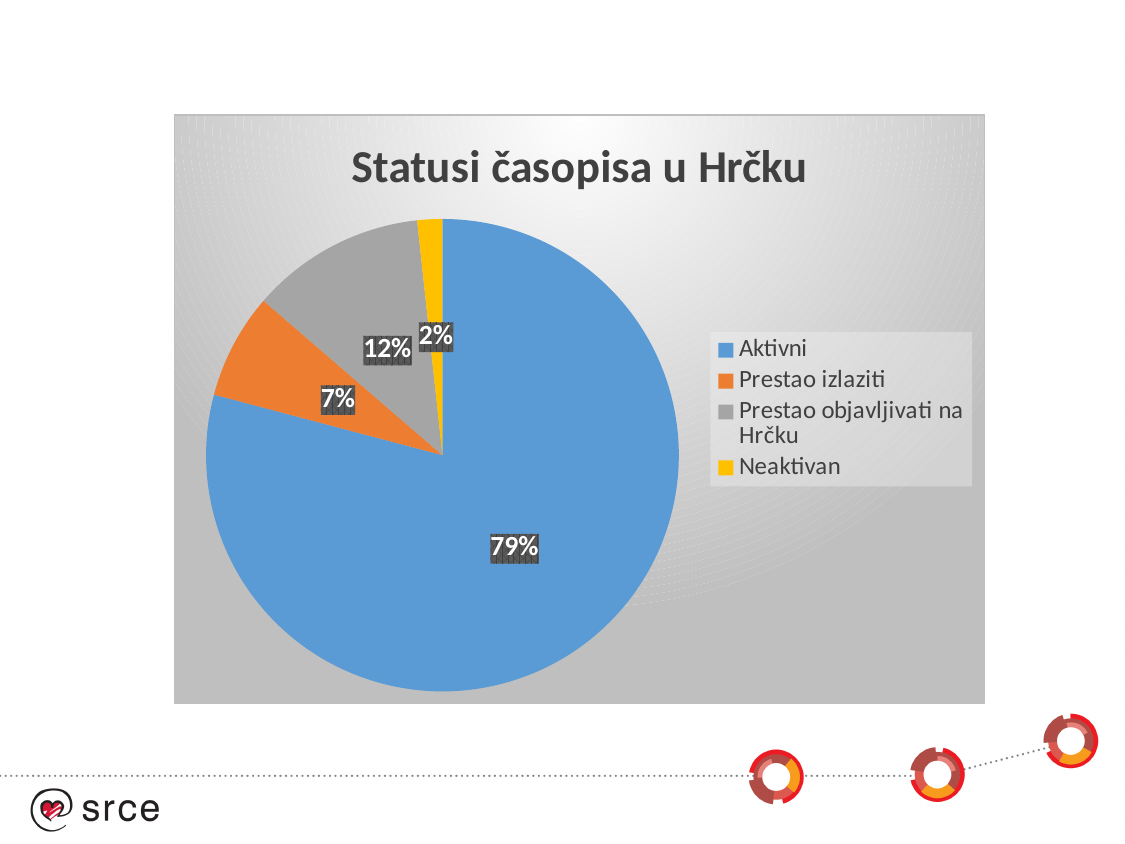
What share of the pie does Prestao objavljivati na Hrčku have? 12% Which category has the smallest slice of the pie? Neaktivan What colour is the Neaktivan slice? yellow What share of the pie does Prestao izlaziti have? 7% Which category has the largest slice of the pie? Aktivni How many categories does the pie chart have? 4 What is the title of the chart? Statusi časopisa u Hrčku What is the difference in percentage points between Aktivni and Prestao objavljivati na Hrčku? 67 What share of the pie does Aktivni have? 79% What kind of chart is shown on the slide? pie chart Which is larger, Prestao izlaziti or Prestao objavljivati na Hrčku? Prestao objavljivati na Hrčku